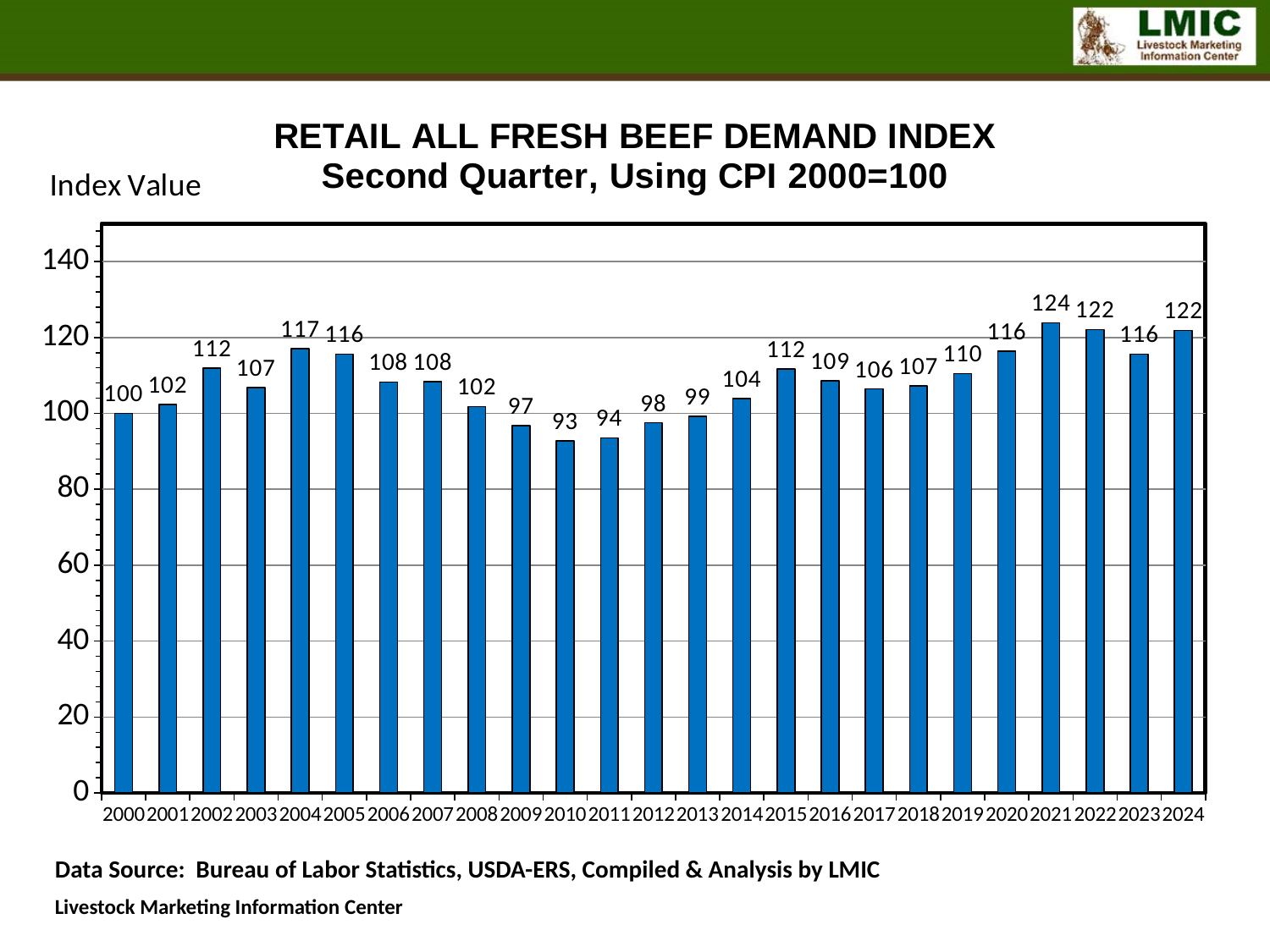
What is the title of the chart? RETAIL ALL FRESH BEEF DEMAND INDEX Second Quarter, Using CPI 2000=100 Do the index values rise or fall from 2010 to 2021? Rise How many years are shown on the x axis? 25 Is the index value for 2023 greater or less than 100? greater Which year has the lowest index value? 2010 What is the difference between the index values for 2021 and 2010? 31 What kind of chart is this? Bar chart What is the index value for 2004? 117 What is the index value for 2010? 93 What is the index value for 2021? 124 Which year has the highest index value? 2021 Which year has a larger index value, 2002 or 2019? 2002